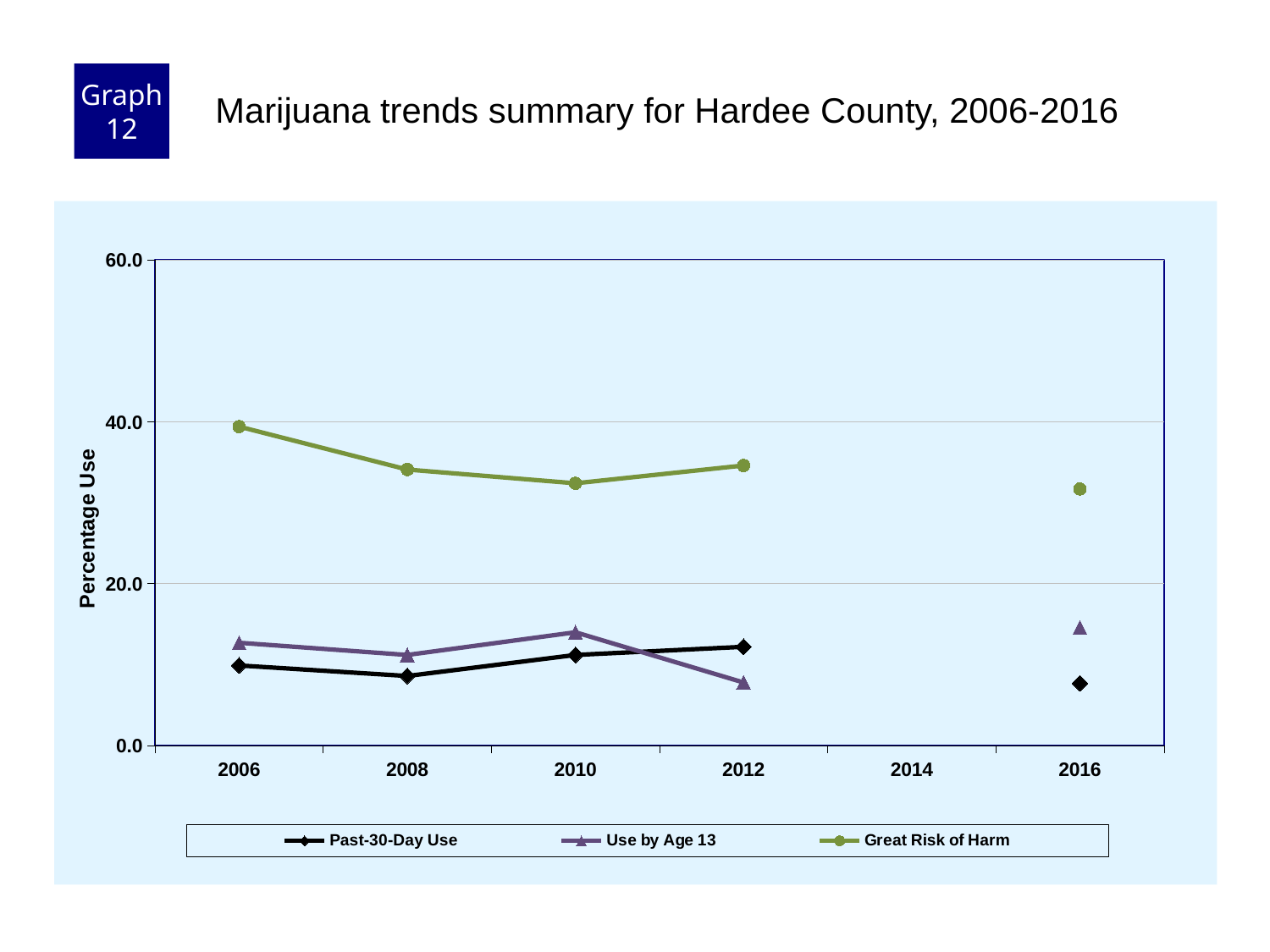
What is the label on the y axis? Percentage Use Does the Great Risk of Harm series rise or fall from 2006 to 2010? fall What kind of chart is shown on the slide? line chart In 2012, which is larger: Past-30-Day Use or Use by Age 13? Past-30-Day Use How many series does the legend list? 3 Is the value for Past-30-Day Use in 2016 greater or less than 20.0? less How many years are labelled on the x axis? 6 Is the value for Great Risk of Harm in 2006 greater or less than 20.0? greater In which year is the Great Risk of Harm value highest? 2006 Is the value for Great Risk of Harm in 2010 greater or less than 40.0? less Which year on the x axis has no data points plotted? 2014 Which series has the highest values across all years shown? Great Risk of Harm